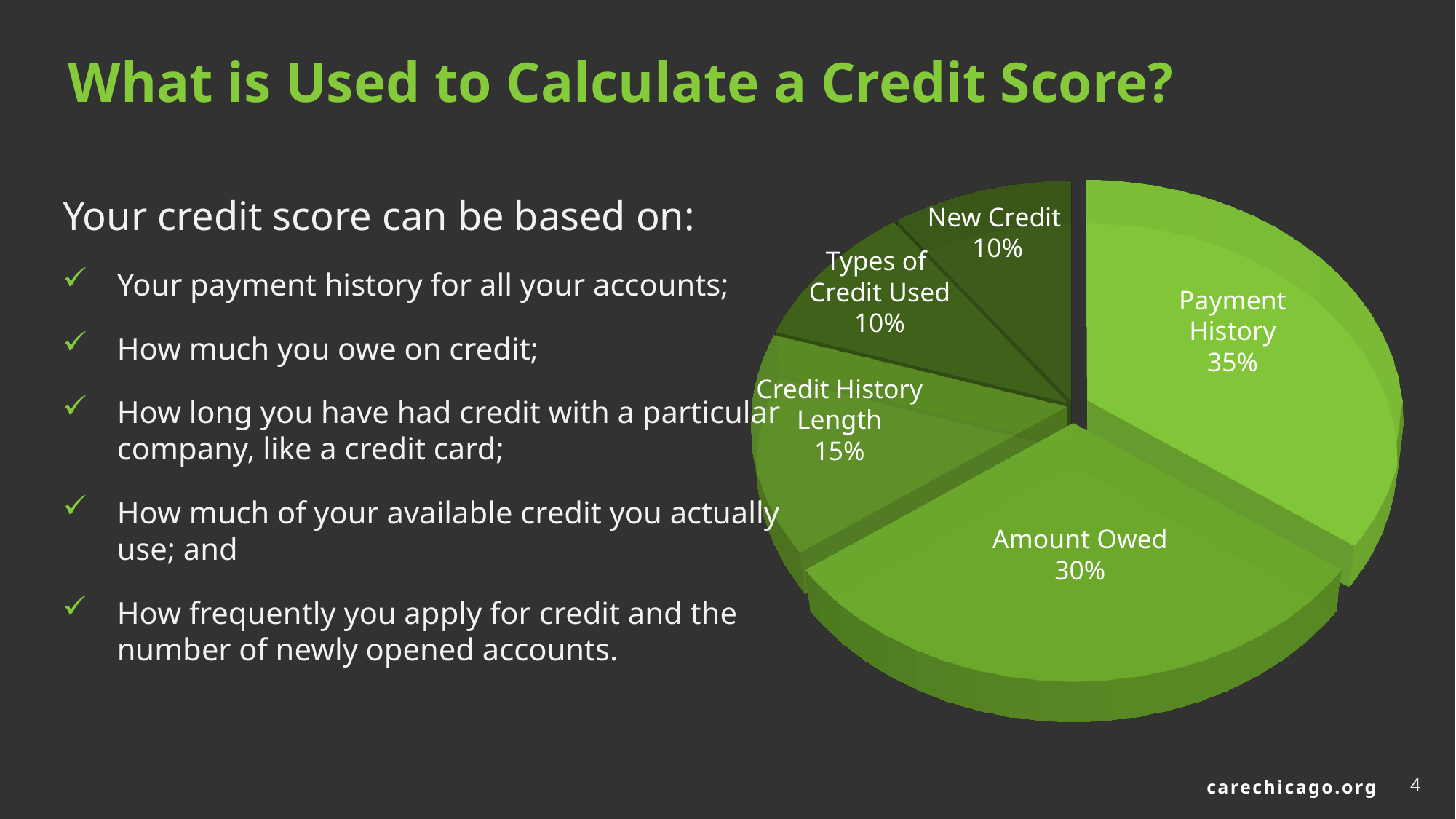
What kind of chart is shown on the slide? Pie chart What percentage is shown for Credit History Length? 15% What is the combined share of Payment History and Amount Owed? 65% Which category has the largest slice of the pie? Payment History What is the difference in percentage points between Payment History and Amount Owed? 5% How many categories are shown in the pie chart? 5 What percentage is shown for Amount Owed? 30% What share of the pie does Payment History represent? 35% What percentage is shown for New Credit? 10% What is the title of the slide containing the pie chart? What is Used to Calculate a Credit Score? Which two categories share the same percentage of 10%? Types of Credit Used and New Credit Which is larger, Credit History Length or Types of Credit Used? Credit History Length